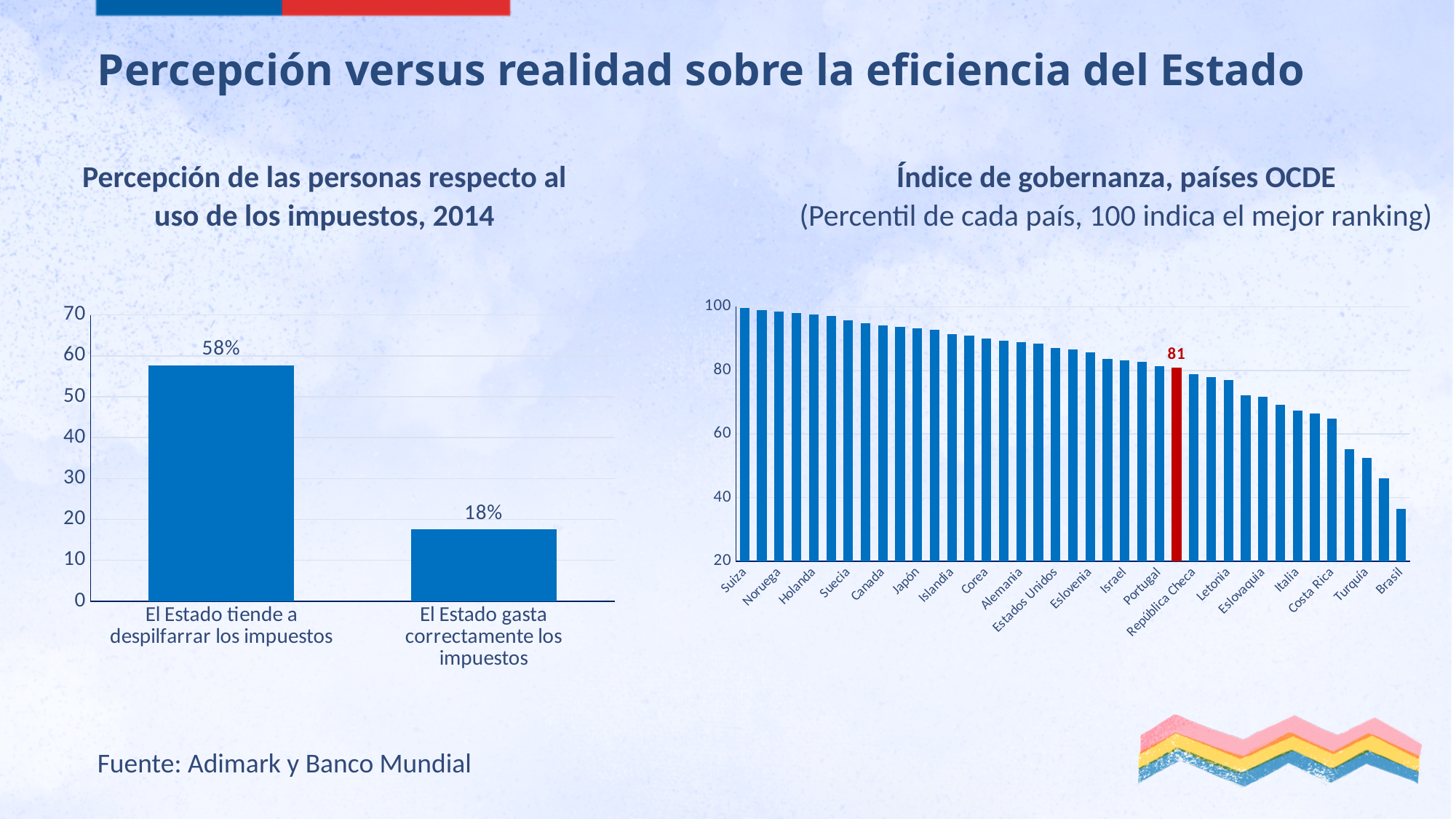
What kind of chart is the left chart 'Percepción de las personas respecto al uso de los impuestos, 2014'? Bar chart In the chart 'Índice de gobernanza, países OCDE', is the value for Suiza greater or less than 80? greater In the left chart on tax perception, which category has the highest value? El Estado tiende a despilfarrar los impuestos In the left chart on tax perception, what is the difference between the two bars? 40 percentage points In the chart 'Índice de gobernanza, países OCDE', what value is printed on the red highlighted bar? 81 In the chart 'Percepción de las personas respecto al uso de los impuestos, 2014', what percentage corresponds to 'El Estado tiende a despilfarrar los impuestos'? 58% In the chart 'Percepción de las personas respecto al uso de los impuestos, 2014', what percentage corresponds to 'El Estado gasta correctamente los impuestos'? 18% In the chart 'Índice de gobernanza, países OCDE', do the values rise or fall from left to right? Fall In the chart 'Índice de gobernanza, países OCDE', is the value for Brasil greater or less than 40? less How many categories are shown in the left chart on tax perception? 2 In the chart 'Índice de gobernanza, países OCDE', what colour is the highlighted bar labelled 81? Red In the chart 'Índice de gobernanza, países OCDE', which has the higher value, Suiza or Brasil? Suiza